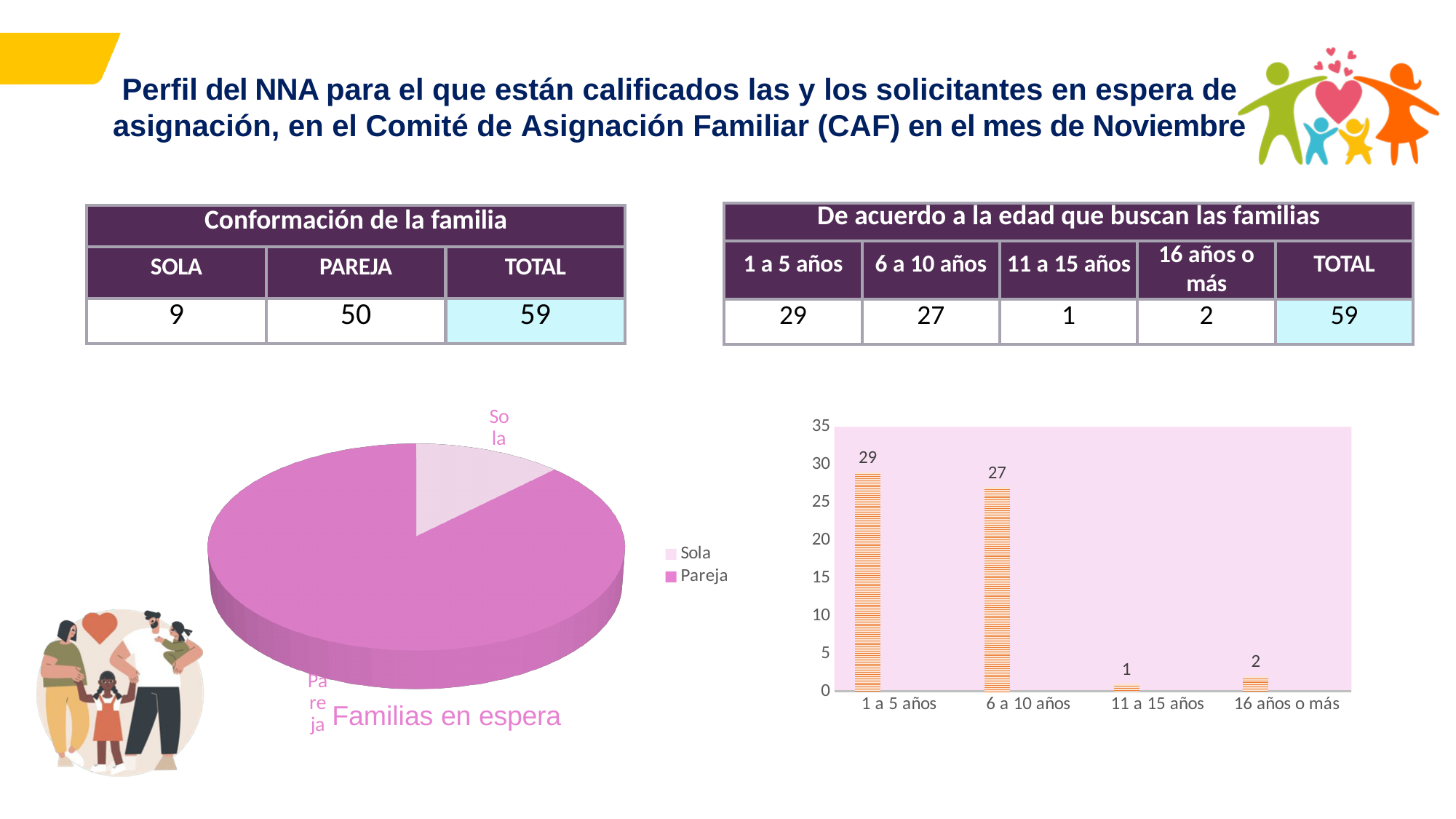
How many entries does the legend of the pie chart on the left list? 2 In the bar chart on the right, what is the difference between the values for '1 a 5 años' and '6 a 10 años'? 2 In the bar chart on the right, what is the value for '11 a 15 años'? 1 In the bar chart on the right, how many age groups are shown on the x axis? 4 What kind of chart is the chart on the right of the slide? bar chart In the bar chart on the right, what is the value for '1 a 5 años'? 29 What kind of chart is the chart on the left of the slide, labelled 'Familias en espera'? pie chart In the pie chart on the left, which slice is larger, Sola or Pareja? Pareja In the bar chart on the right, which age group has the lowest value? 11 a 15 años In the bar chart on the right, what is the value for '6 a 10 años'? 27 In the bar chart on the right, what is the value for '16 años o más'? 2 In the bar chart on the right, which age group has the highest value? 1 a 5 años